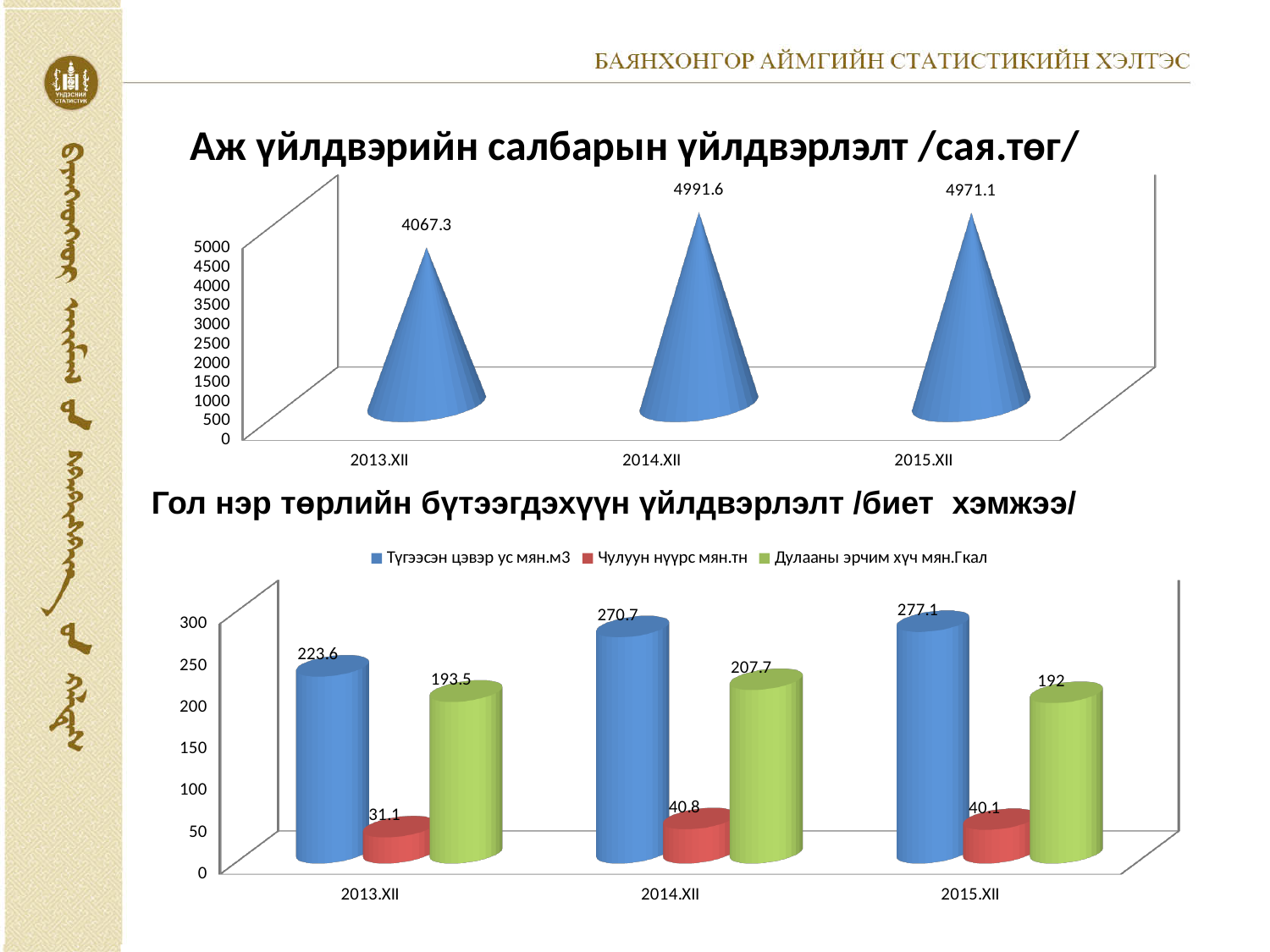
In the bottom chart (Гол нэр төрлийн бүтээгдэхүүн үйлдвэрлэлт /биет хэмжээ/), which period has the highest value for Түгээсэн цэвэр ус мян.м3? 2015.XII In the top chart (Аж үйлдвэрийн салбарын үйлдвэрлэлт /сая.төг/), what is the difference between the 2014.XII and 2013.XII values? 924.3 In the top chart (Аж үйлдвэрийн салбарын үйлдвэрлэлт /сая.төг/), which period has the lowest value? 2013.XII What kind of chart is the bottom chart (Гол нэр төрлийн бүтээгдэхүүн үйлдвэрлэлт /биет хэмжээ/)? bar chart How many periods are shown on the x axis of the top chart (Аж үйлдвэрийн салбарын үйлдвэрлэлт /сая.төг/)? 3 In the top chart (Аж үйлдвэрийн салбарын үйлдвэрлэлт /сая.төг/), what is the value for 2013.XII? 4067.3 In the bottom chart (Гол нэр төрлийн бүтээгдэхүүн үйлдвэрлэлт /биет хэмжээ/), what is the value of Чулуун нүүрс мян.тн for 2014.XII? 40.8 How many series does the legend of the bottom chart (Гол нэр төрлийн бүтээгдэхүүн үйлдвэрлэлт /биет хэмжээ/) list? 3 In the bottom chart (Гол нэр төрлийн бүтээгдэхүүн үйлдвэрлэлт /биет хэмжээ/), what is the difference between the Түгээсэн цэвэр ус мян.м3 values for 2014.XII and 2013.XII? 47.1 In the bottom chart (Гол нэр төрлийн бүтээгдэхүүн үйлдвэрлэлт /биет хэмжээ/), what is the value of Дулааны эрчим хүч мян.Гкал for 2015.XII? 192 In the bottom chart (Гол нэр төрлийн бүтээгдэхүүн үйлдвэрлэлт /биет хэмжээ/), is the value of Дулааны эрчим хүч мян.Гкал for 2014.XII larger or smaller than for 2013.XII? larger In the top chart (Аж үйлдвэрийн салбарын үйлдвэрлэлт /сая.төг/), which period has the highest value? 2014.XII